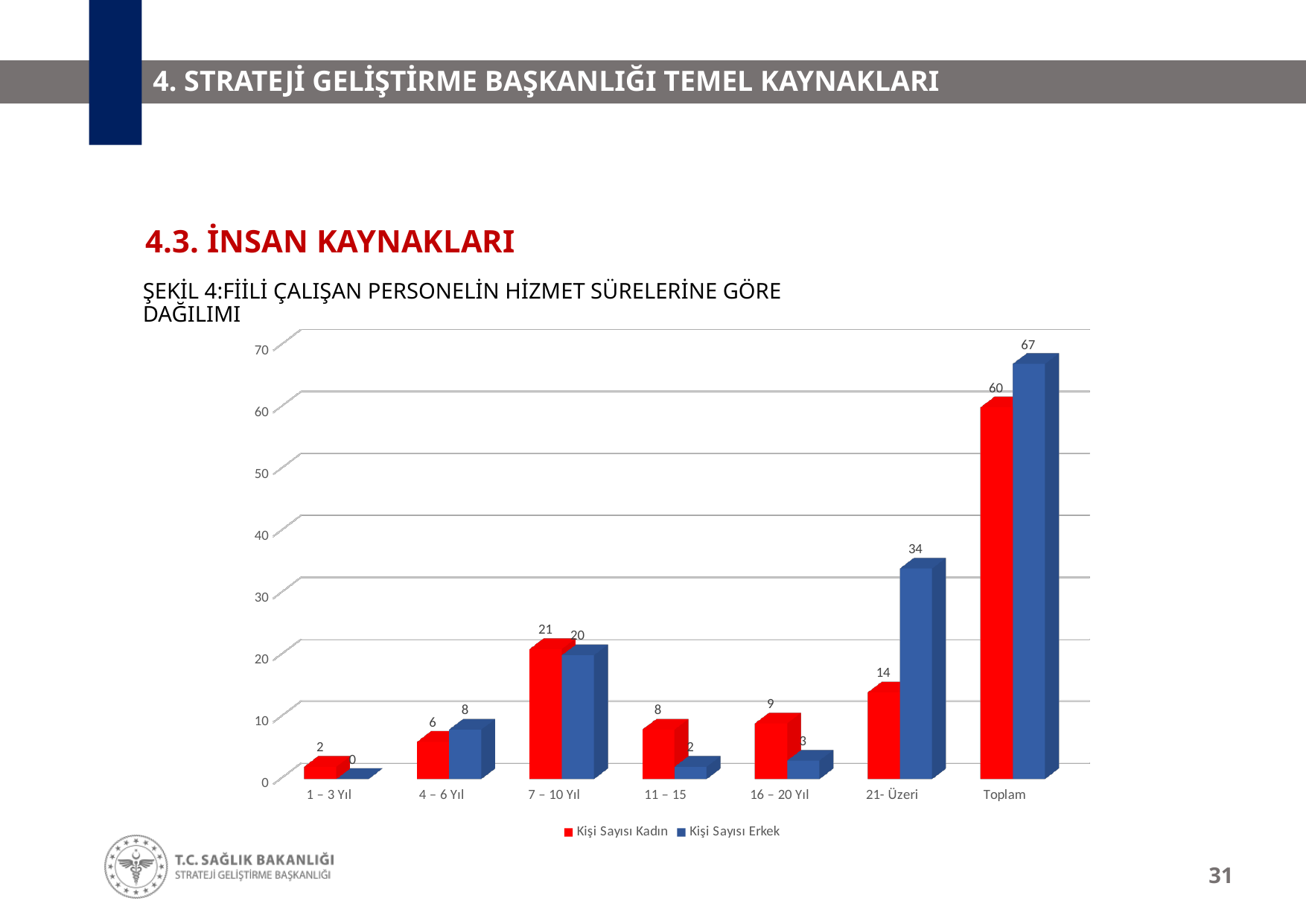
What is the Kişi Sayısı Erkek value for 4 – 6 Yıl? 8 What is the Kişi Sayısı Kadın value for 7 – 10 Yıl? 21 What is the difference between the Kişi Sayısı Erkek and Kişi Sayısı Kadın values for Toplam? 7 What is the Kişi Sayısı Kadın value for Toplam? 60 Excluding Toplam, which category has the highest Kişi Sayısı Erkek value? 21- Üzeri What is the Kişi Sayısı Erkek value for 21- Üzeri? 34 How many series does the legend list? 2 What kind of chart is shown on the slide? Bar chart Which category has the lowest Kişi Sayısı Kadın value? 1 – 3 Yıl For 21- Üzeri, which series has the larger value, Kişi Sayısı Kadın or Kişi Sayısı Erkek? Kişi Sayısı Erkek How many categories are shown on the x axis? 7 Is the Kişi Sayısı Kadın value for 16 – 20 Yıl greater or less than 10? less